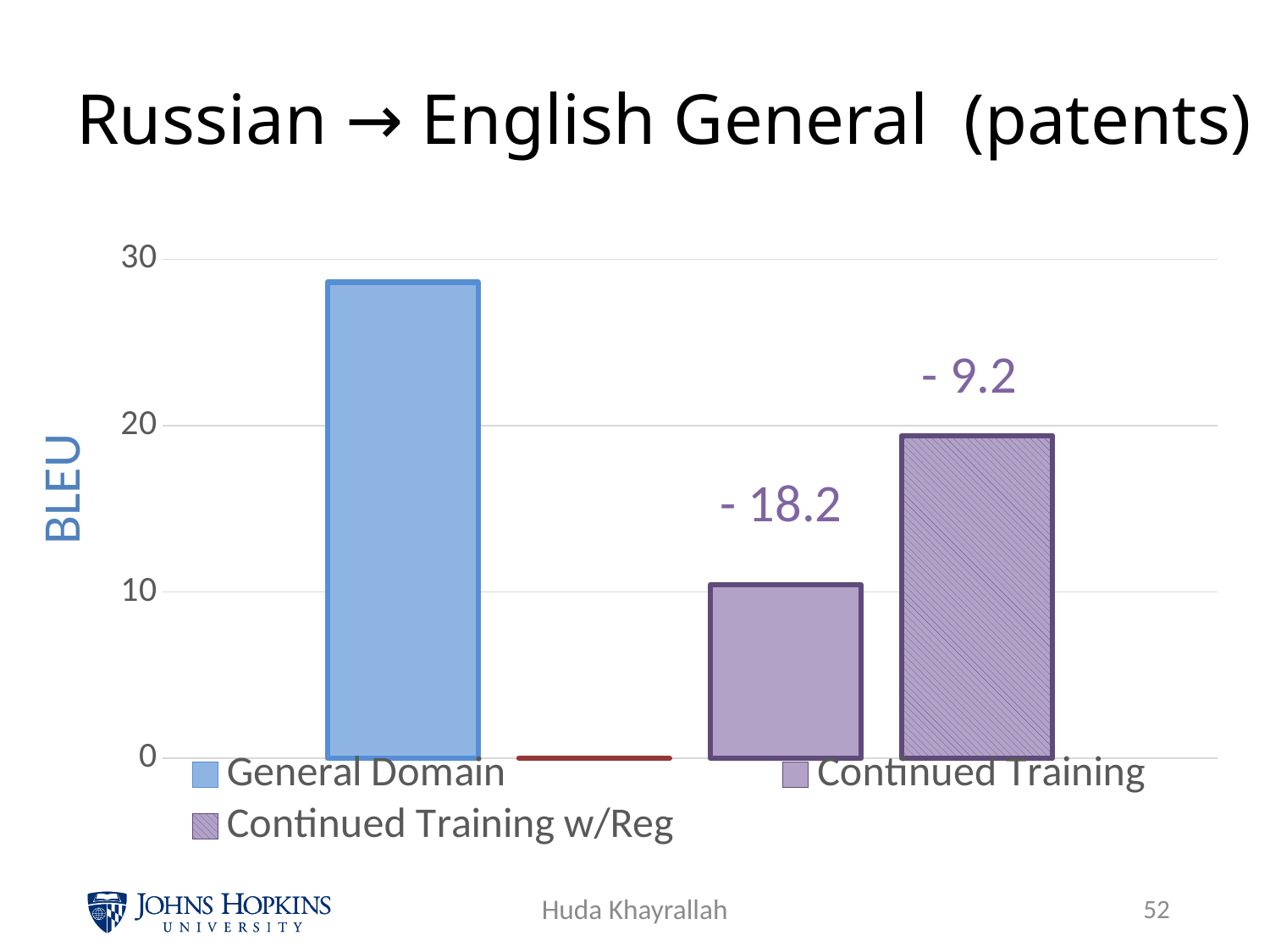
Is the BLEU value for Continued Training greater or less than 20? less Is the BLEU value for General Domain greater or less than 20? greater Which series has the highest BLEU score? General Domain Which has a higher BLEU score, Continued Training or Continued Training w/Reg? Continued Training w/Reg Is the BLEU value for General Domain greater or less than 30? less What is the label on the vertical axis? BLEU What is the title of the chart? Russian → English General (patents) What label is printed above the Continued Training w/Reg bar? - 9.2 What kind of chart is shown on the slide? bar chart How many series does the legend list? 3 What label is printed above the Continued Training bar? - 18.2